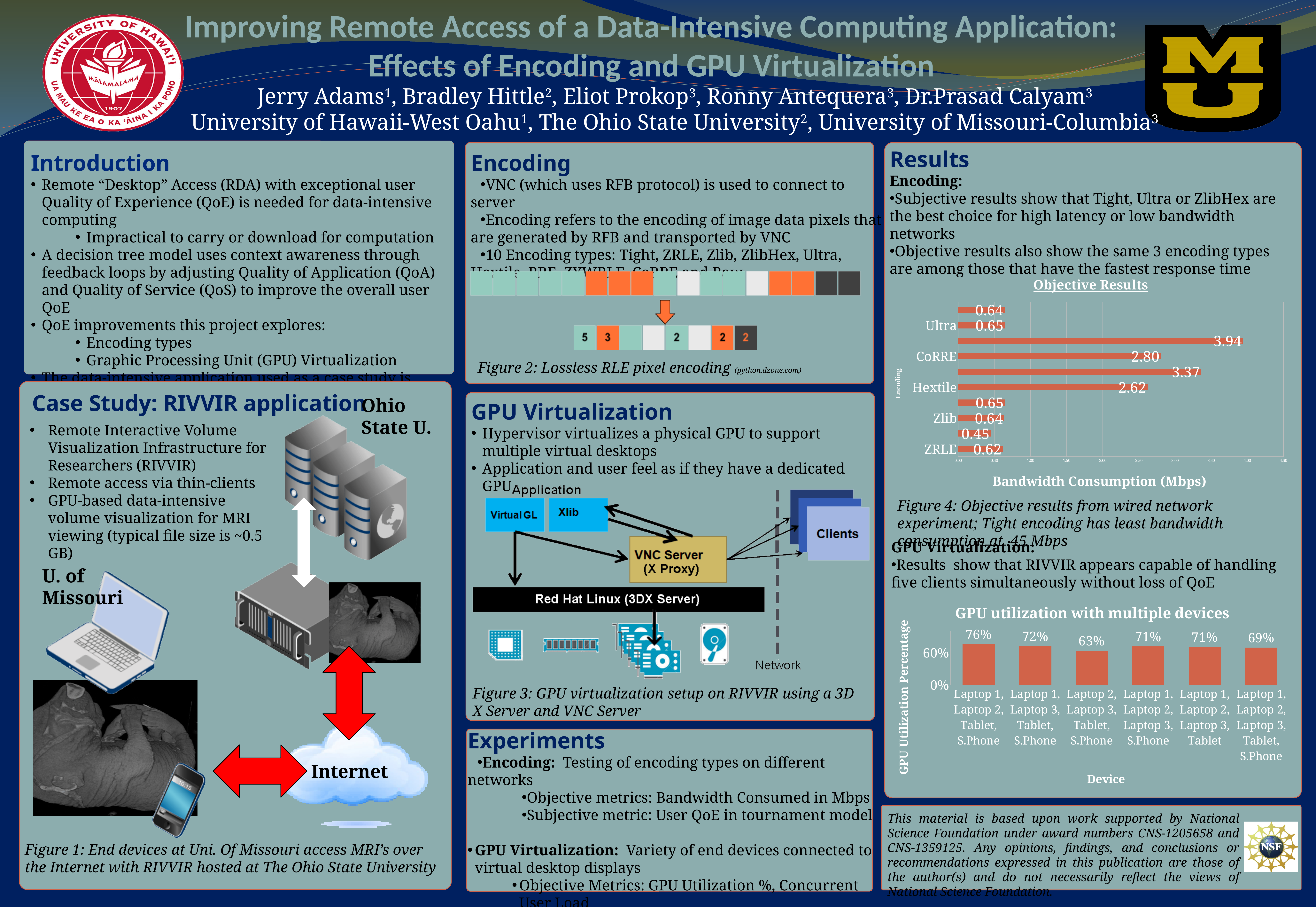
In the 'Objective Results' chart, what is the bandwidth consumption for CoRRE encoding? 2.80 What kind of chart is 'GPU utilization with multiple devices'? Bar chart How many bars are plotted in the 'Objective Results' chart? 10 In the 'GPU utilization with multiple devices' chart, which device combination has the highest GPU utilization? Laptop 1, Laptop 2, Tablet, S.Phone In the 'GPU utilization with multiple devices' chart, which device combination has the lowest GPU utilization? Laptop 2, Laptop 3, Tablet, S.Phone In the 'GPU utilization with multiple devices' chart, what is the difference between the highest and lowest GPU utilization values? 13% In the 'Objective Results' chart, what is the bandwidth consumption for Hextile encoding? 2.62 How many device combinations are plotted in the 'GPU utilization with multiple devices' chart? 6 What is the x-axis label of the 'Objective Results' chart? Bandwidth Consumption (Mbps) In the 'GPU utilization with multiple devices' chart, what is the GPU utilization for the device combination 'Laptop 1, Laptop 2, Tablet, S.Phone'? 76% In the 'GPU utilization with multiple devices' chart, what is the GPU utilization for 'Laptop 2, Laptop 3, Tablet, S.Phone'? 63% In the 'Objective Results' chart, which has higher bandwidth consumption, CoRRE or Zlib? CoRRE